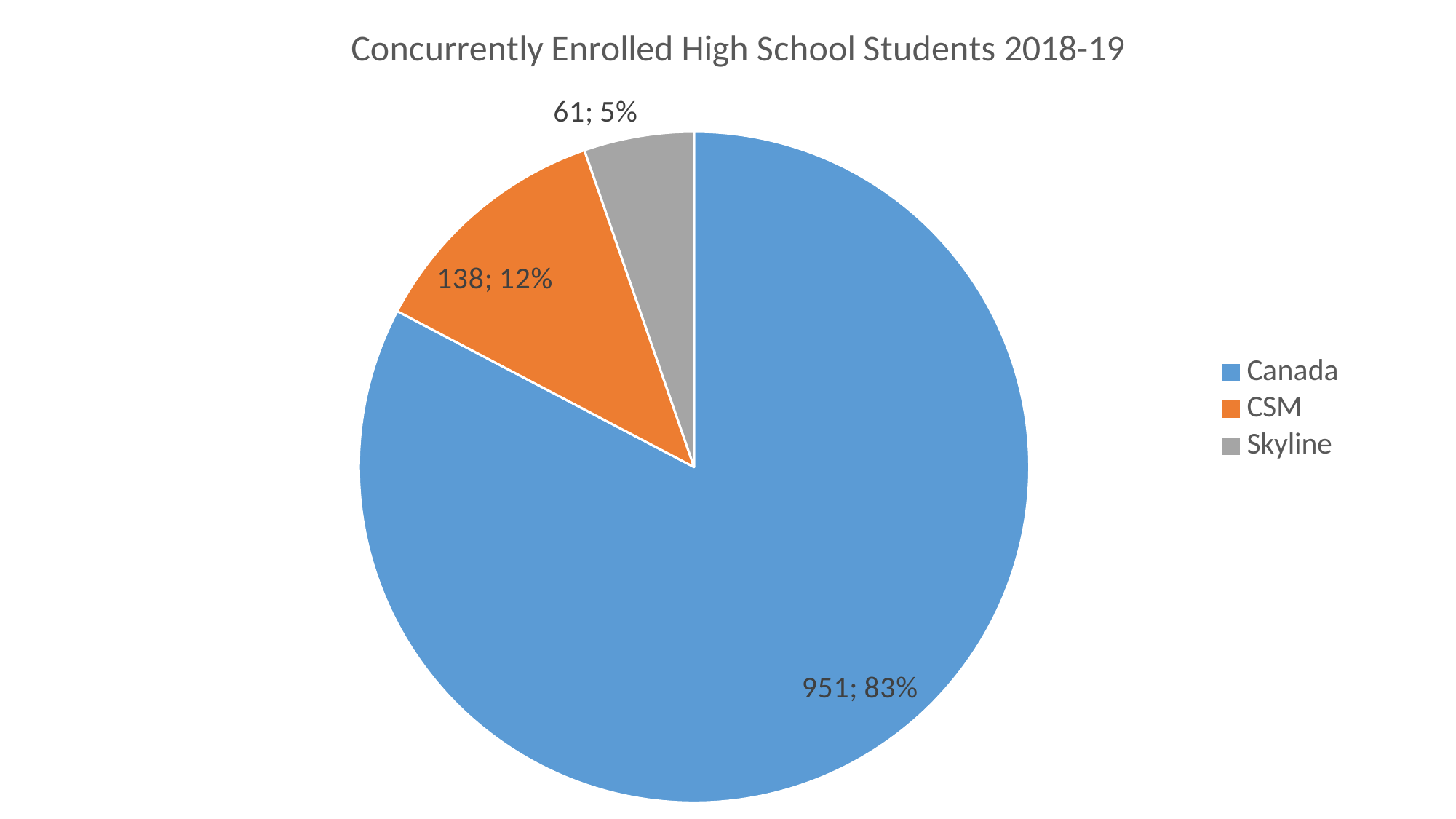
How many students are shown for Canada? 951 What is the difference in student count between CSM and Skyline? 77 What is the title of the chart? Concurrently Enrolled High School Students 2018-19 What share of the pie does Canada represent? 83% What share of the pie does Skyline represent? 5% Which college has the largest slice? Canada Which college has the smallest slice? Skyline How many students are shown for Skyline? 61 What type of chart is shown on the slide? pie chart How many students are shown for CSM? 138 How many categories does the legend list? 3 Which has more students, CSM or Skyline? CSM